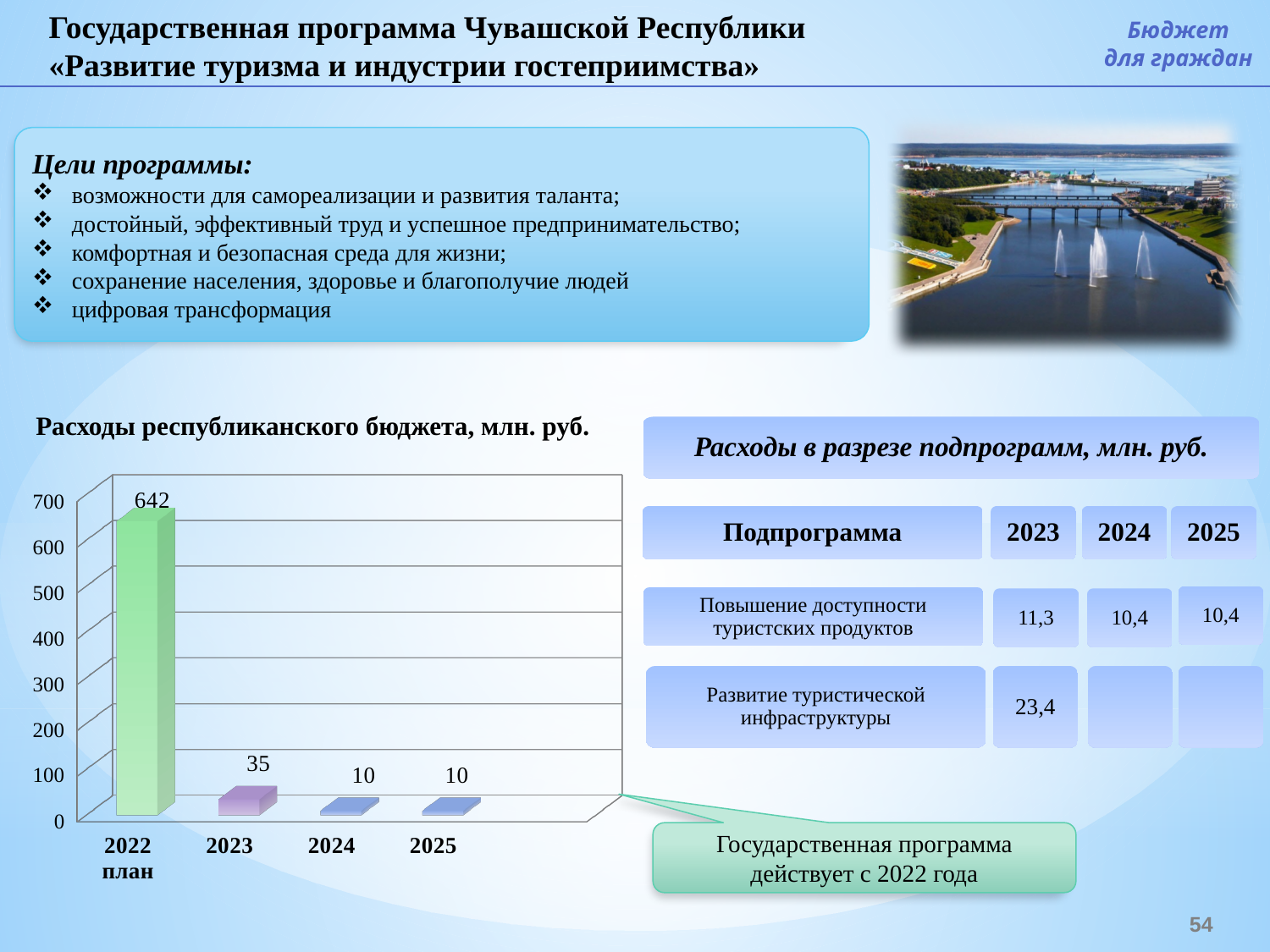
Which is larger in the chart 'Расходы республиканского бюджета, млн. руб.': the value for 2023 or the value for 2025? 2023 What is the value for 2024 in the chart 'Расходы республиканского бюджета, млн. руб.'? 10 How many categories are shown on the x axis of the chart 'Расходы республиканского бюджета, млн. руб.'? 4 What kind of chart is 'Расходы республиканского бюджета, млн. руб.'? bar chart Is the value for 2022 план greater or less than 600 in the chart 'Расходы республиканского бюджета, млн. руб.'? greater What is the value for 2023 in the chart 'Расходы республиканского бюджета, млн. руб.'? 35 Do the values in the chart 'Расходы республиканского бюджета, млн. руб.' rise or fall from 2022 план to 2024? fall What is the value for 2025 in the chart 'Расходы республиканского бюджета, млн. руб.'? 10 What is the value for 2022 план in the chart 'Расходы республиканского бюджета, млн. руб.'? 642 Which category has the highest value in the chart 'Расходы республиканского бюджета, млн. руб.'? 2022 план What is the difference between the values for 2023 and 2024 in the chart 'Расходы республиканского бюджета, млн. руб.'? 25 What is the difference between the values for 2022 план and 2023 in the chart 'Расходы республиканского бюджета, млн. руб.'? 607